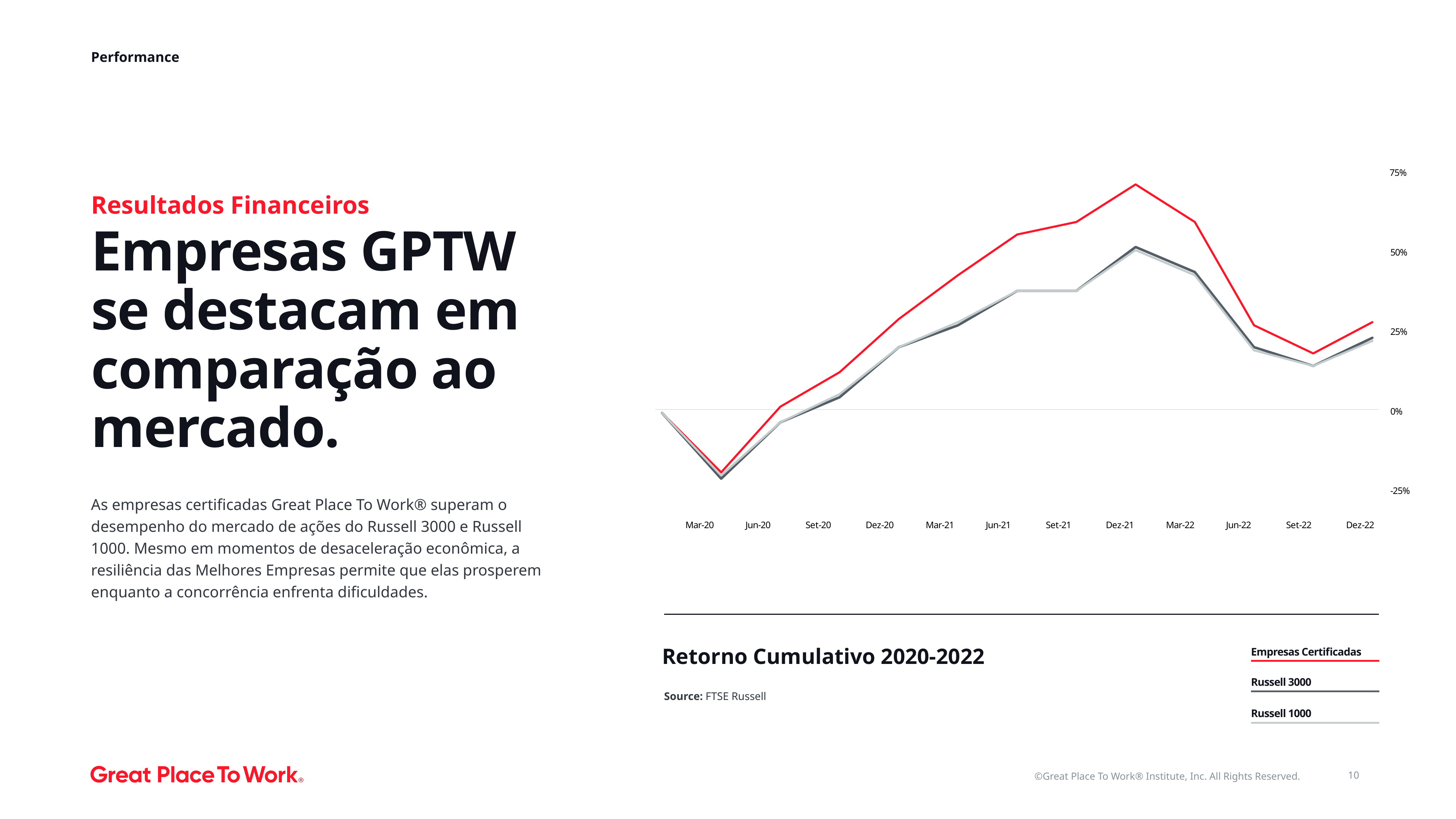
Is the value for Russell 3000 at Set-22 greater or less than 25%? less Which series is drawn in red in the chart? Empresas Certificadas How many points are shown along the x axis of the chart? 12 Do the values for Empresas Certificadas rise or fall from Dez-21 to Set-22? fall At which x-axis point does the Empresas Certificadas line reach its lowest value? Mar-20 What is the title of the chart? Retorno Cumulativo 2020-2022 Is the value for Empresas Certificadas at Dez-21 greater or less than 50%? greater How many series does the chart's legend list? 3 What kind of chart is shown on the slide? line chart At Dez-21, which is larger: the value for Empresas Certificadas or the value for Russell 3000? Empresas Certificadas At which x-axis point does the Empresas Certificadas line reach its highest value? Dez-21